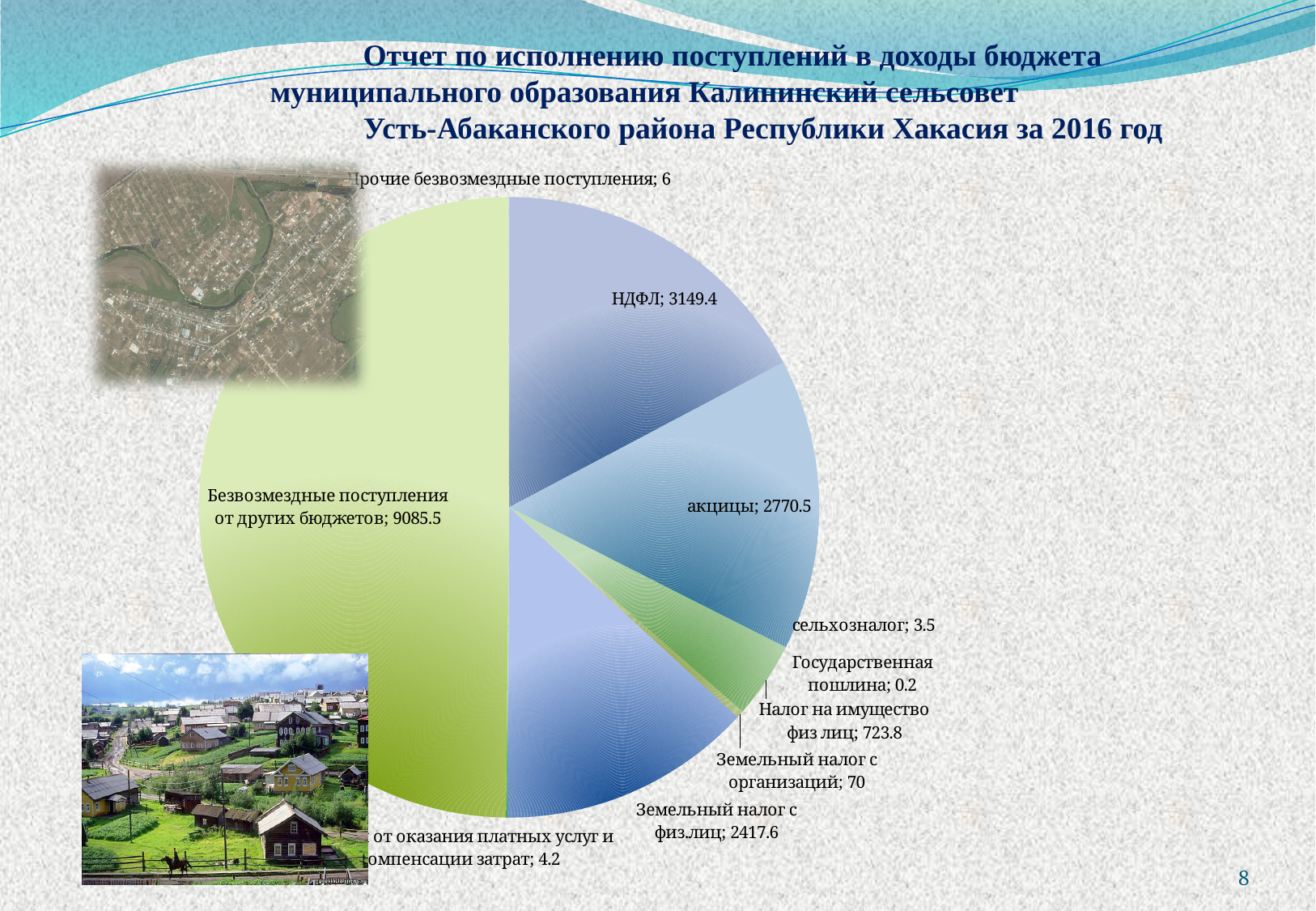
What is the value for НДФЛ? 3149.4 What is the value for акцизы? 2770.5 Which category has the largest slice of the pie? Безвозмездные поступления от других бюджетов What is the value for Безвозмездные поступления от других бюджетов? 9085.5 What is the value for Налог на имущество физ лиц? 723.8 What is the value for Государственная пошлина? 0.2 Which category has the smallest value in the pie chart? Государственная пошлина Which is larger, Земельный налог с организаций or Налог на имущество физ лиц? Налог на имущество физ лиц What kind of chart is shown on the slide? pie chart How many categories are shown in the pie chart? 10 What is the difference between the values for НДФЛ and акцизы? 378.9 What is the value for Земельный налог с физ.лиц? 2417.6